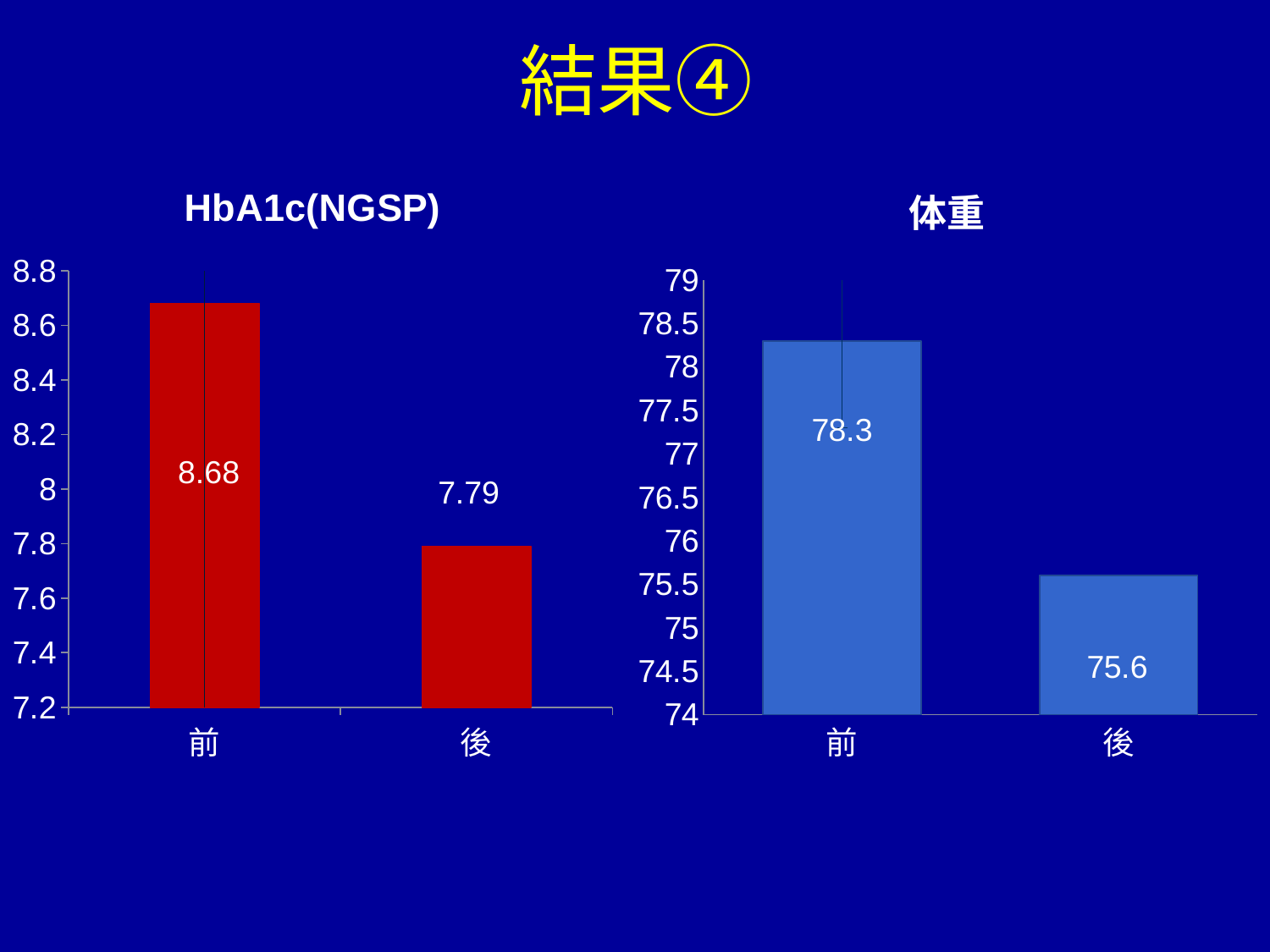
In the HbA1c(NGSP) chart, what is the value for 前? 8.68 In the 体重 chart, what is the difference between the values for 前 and 後? 2.7 In the HbA1c(NGSP) chart, which category has the higher value? 前 In the HbA1c(NGSP) chart, what is the difference between the values for 前 and 後? 0.89 In the HbA1c(NGSP) chart, what is the value for 後? 7.79 In the HbA1c(NGSP) chart, do the values rise or fall from 前 to 後? fall In the 体重 chart, what is the value for 後? 75.6 In the 体重 chart, is the value for 後 greater or less than 76? less What kind of chart is the 体重 chart? bar chart In the 体重 chart, what is the value for 前? 78.3 How many categories does the HbA1c(NGSP) chart show? 2 In the 体重 chart, which category has the lower value? 後